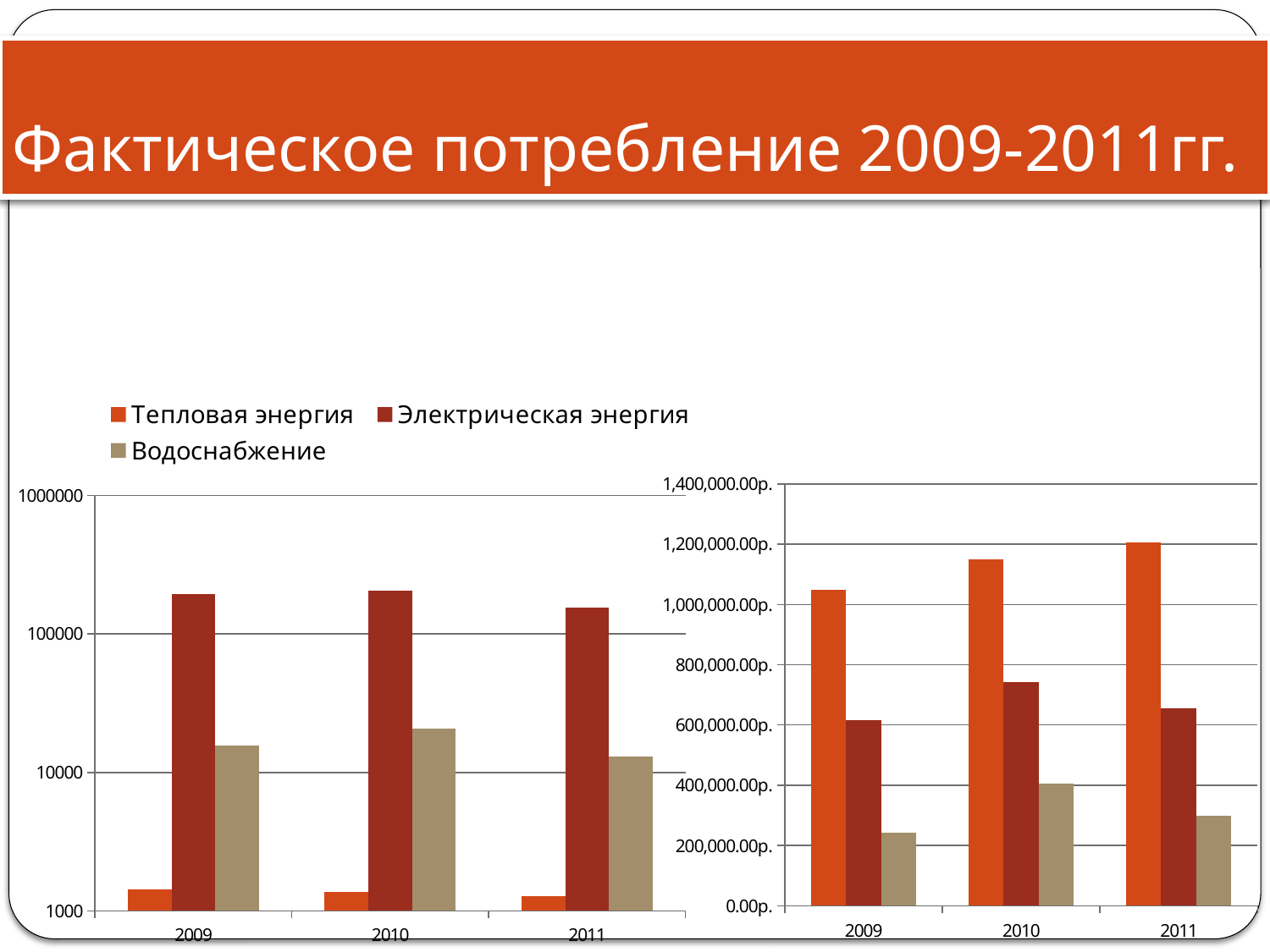
In the right chart, which series has the highest value in 2011? Тепловая энергия What kind of chart is the left chart on the slide? bar chart In the right chart, is the value for Тепловая энергия in 2011 greater or less than 1,000,000.00р.? greater In the left chart, is the value for Электрическая энергия in 2010 greater or less than 100000? greater In the left chart, which series has the lowest value in 2009? Тепловая энергия In the right chart, how many years are shown on the x axis? 3 In the right chart, is the value for Электрическая энергия larger in 2010 or in 2011? 2010 In the right chart, is the value for Водоснабжение in 2009 greater or less than 400,000.00р.? less What is the title of the slide? Фактическое потребление 2009-2011гг. In the right chart, do the values for Тепловая энергия rise or fall from 2009 to 2011? rise In the left chart, is the value for Водоснабжение larger in 2010 or in 2011? 2010 How many series does the legend list? 3